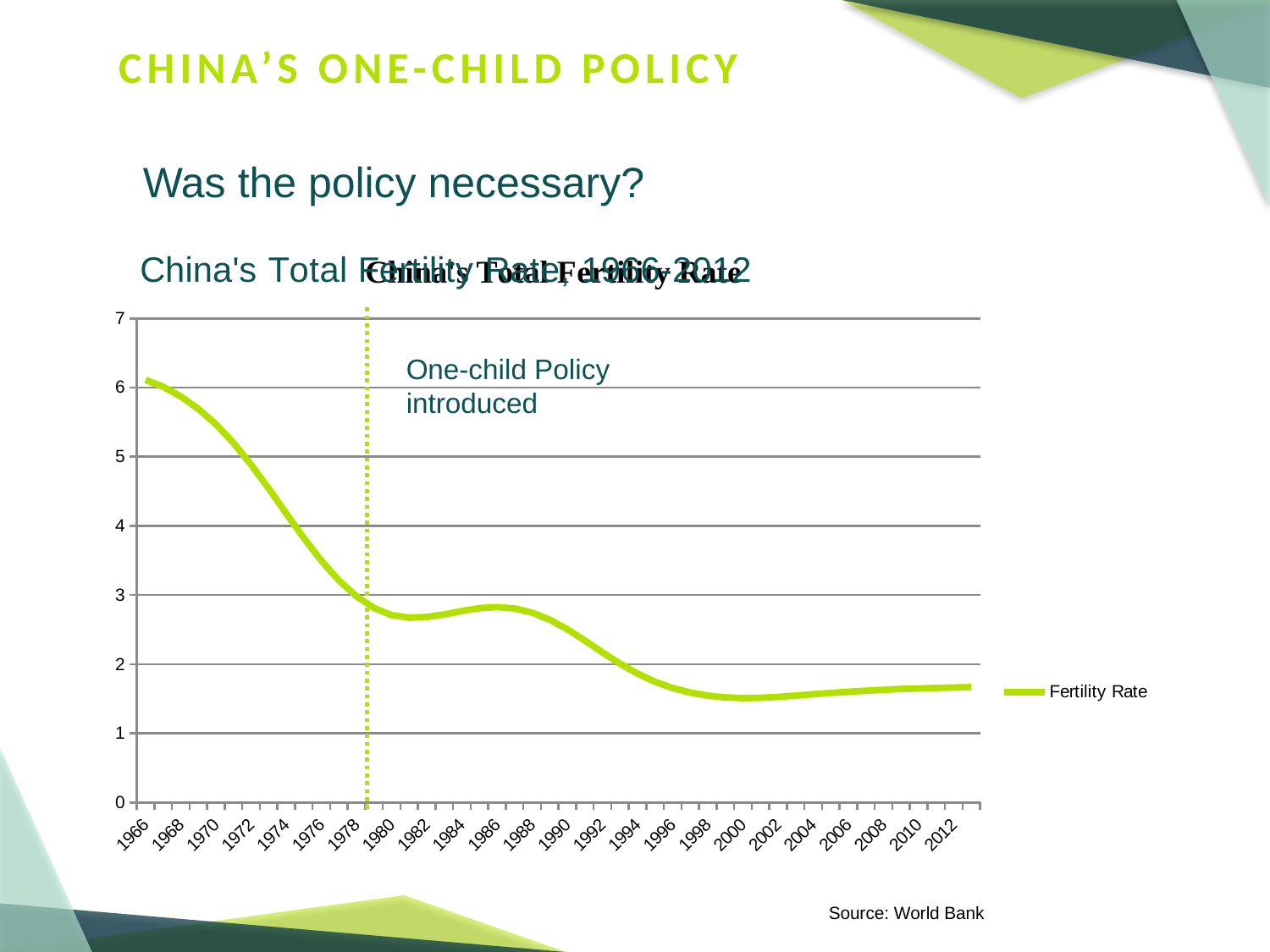
Is the fertility rate for 1970 greater or less than 5? greater What kind of chart is shown on the slide? line chart Is the fertility rate for 2000 greater or less than 2? less Is the fertility rate for 2012 greater or less than 2? less What event does the dotted vertical line on the chart mark? One-child Policy introduced What is the name of the series shown in the legend? Fertility Rate Which year has the larger fertility rate, 1990 or 2000? 1990 Overall, does the fertility rate rise or fall from 1966 to 2012? fall How many series does the legend list? 1 Which year on the x axis has the highest fertility rate? 1966